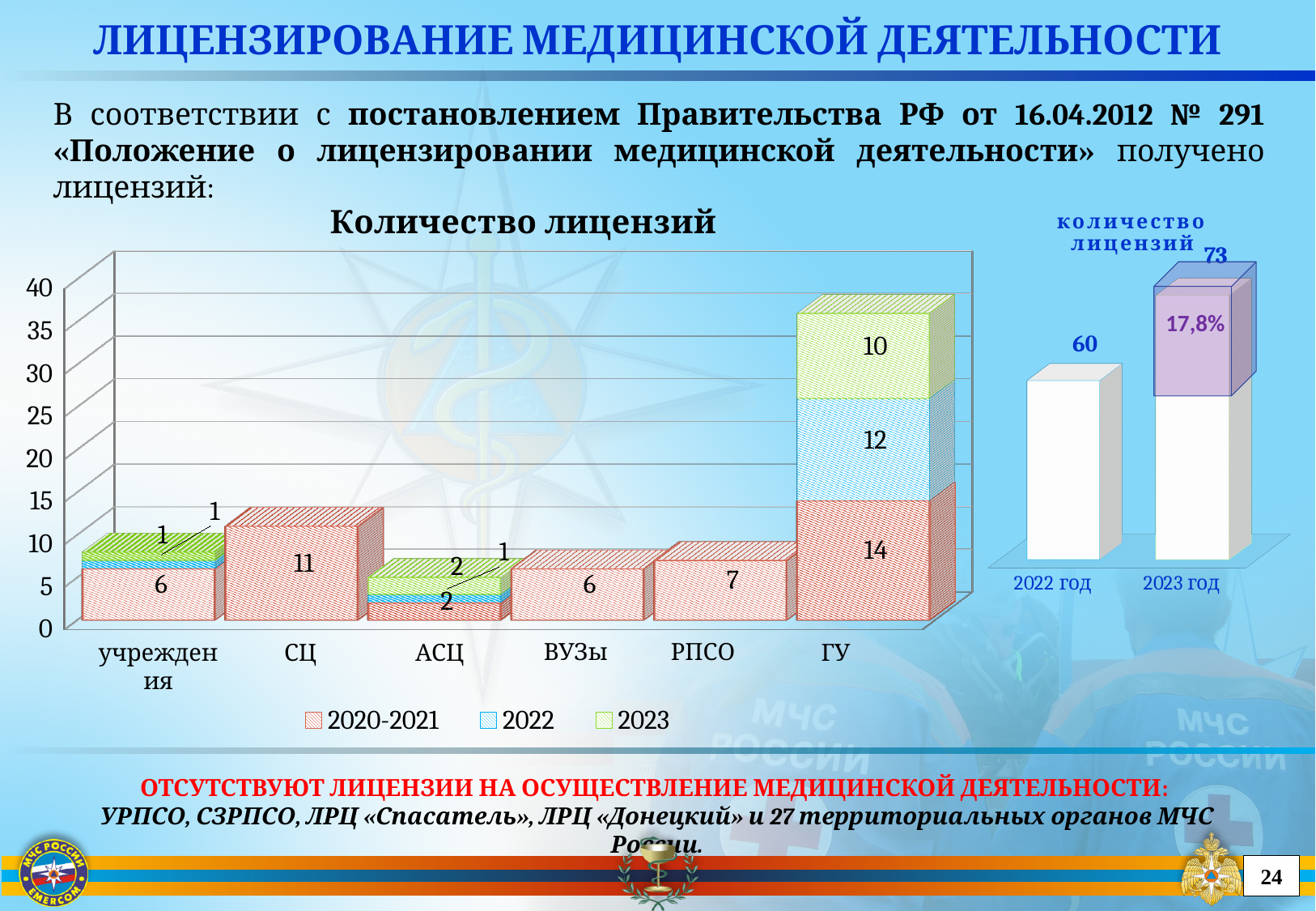
In the chart titled 'Количество лицензий', how many series does the legend list? 3 In the chart titled 'Количество лицензий', what is the 2022 value for ГУ? 12 In the chart titled 'Количество лицензий', which category has the highest stacked bar? ГУ In the chart on the right titled 'количество лицензий', what is the value for 2023 год? 73 What kind of chart is the chart on the right titled 'количество лицензий'? bar chart In the chart titled 'Количество лицензий', what is the 2020-2021 value for РПСО? 7 In the chart titled 'Количество лицензий', what is the total of the stacked bar for ГУ? 36 In the chart on the right titled 'количество лицензий', what is the difference between the values for 2023 год and 2022 год? 13 In the chart titled 'Количество лицензий', how many categories are shown on the x axis? 6 In the chart titled 'Количество лицензий', what is the 2020-2021 value for СЦ? 11 In the chart titled 'Количество лицензий', what is the difference between the 2020-2021 values for ГУ and ВУЗы? 8 In the chart titled 'Количество лицензий', what is the 2020-2021 value for ГУ? 14